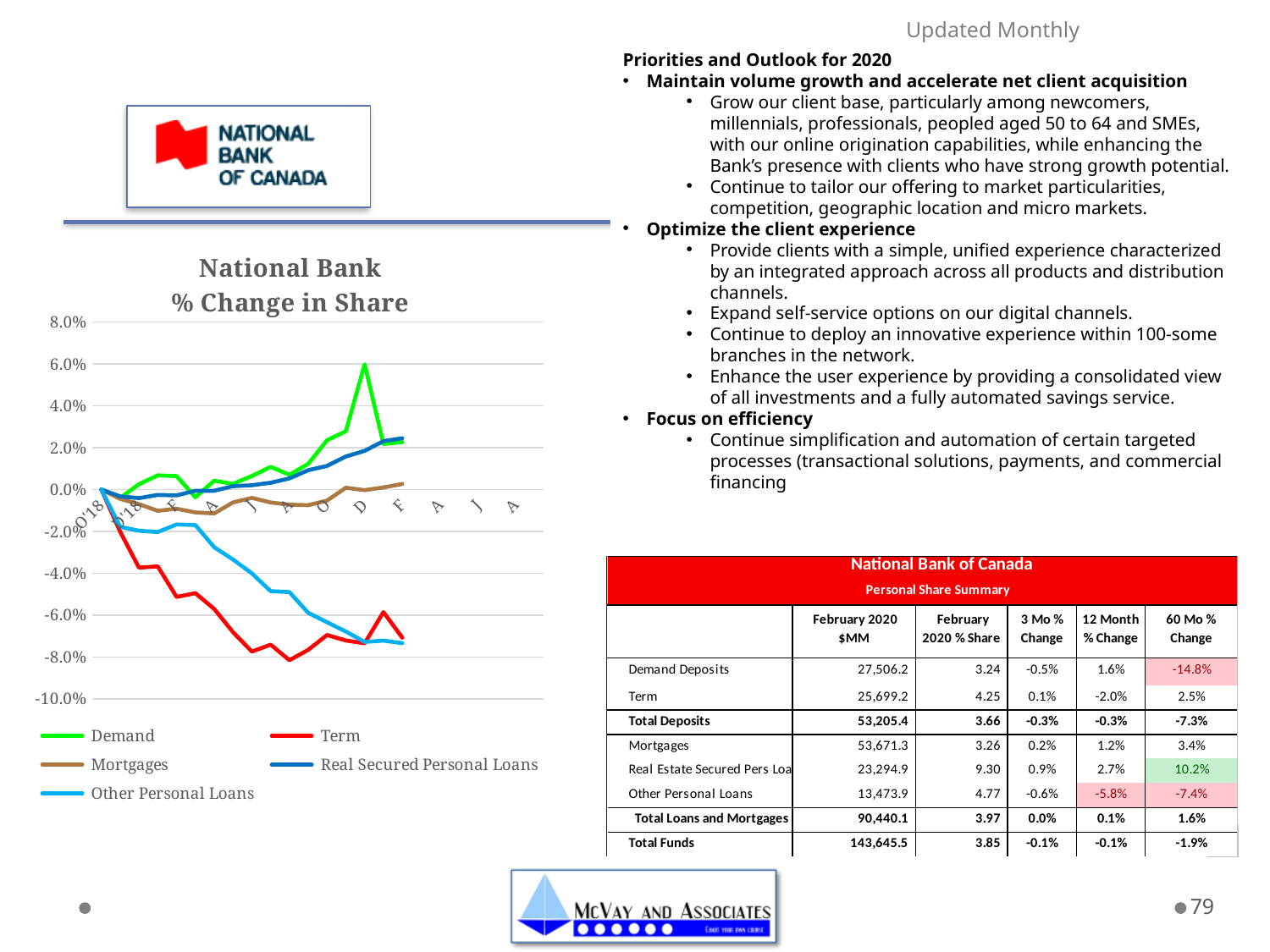
In the '% Change in Share' chart, is the final value of the Other Personal Loans series greater or less than -6.0%? less In the '% Change in Share' chart, at the last plotted point, which is higher: Demand or Term? Demand Which series in the '% Change in Share' chart is drawn in green? Demand How many series does the legend of the '% Change in Share' chart list? 5 In the '% Change in Share' chart, is the final value of the Term series greater or less than -4.0%? less What is the title of the line chart on the slide? National Bank % Change in Share In the '% Change in Share' chart, which series reaches the lowest value? Term In the '% Change in Share' chart, is the peak value of the Demand series greater or less than 4.0%? greater In the '% Change in Share' chart, which series reaches the highest value? Demand In the '% Change in Share' chart, does the Real Secured Personal Loans series generally rise or fall over time? rise What kind of chart is the 'National Bank % Change in Share' chart? line chart In the '% Change in Share' chart, does the Other Personal Loans series generally rise or fall over time? fall